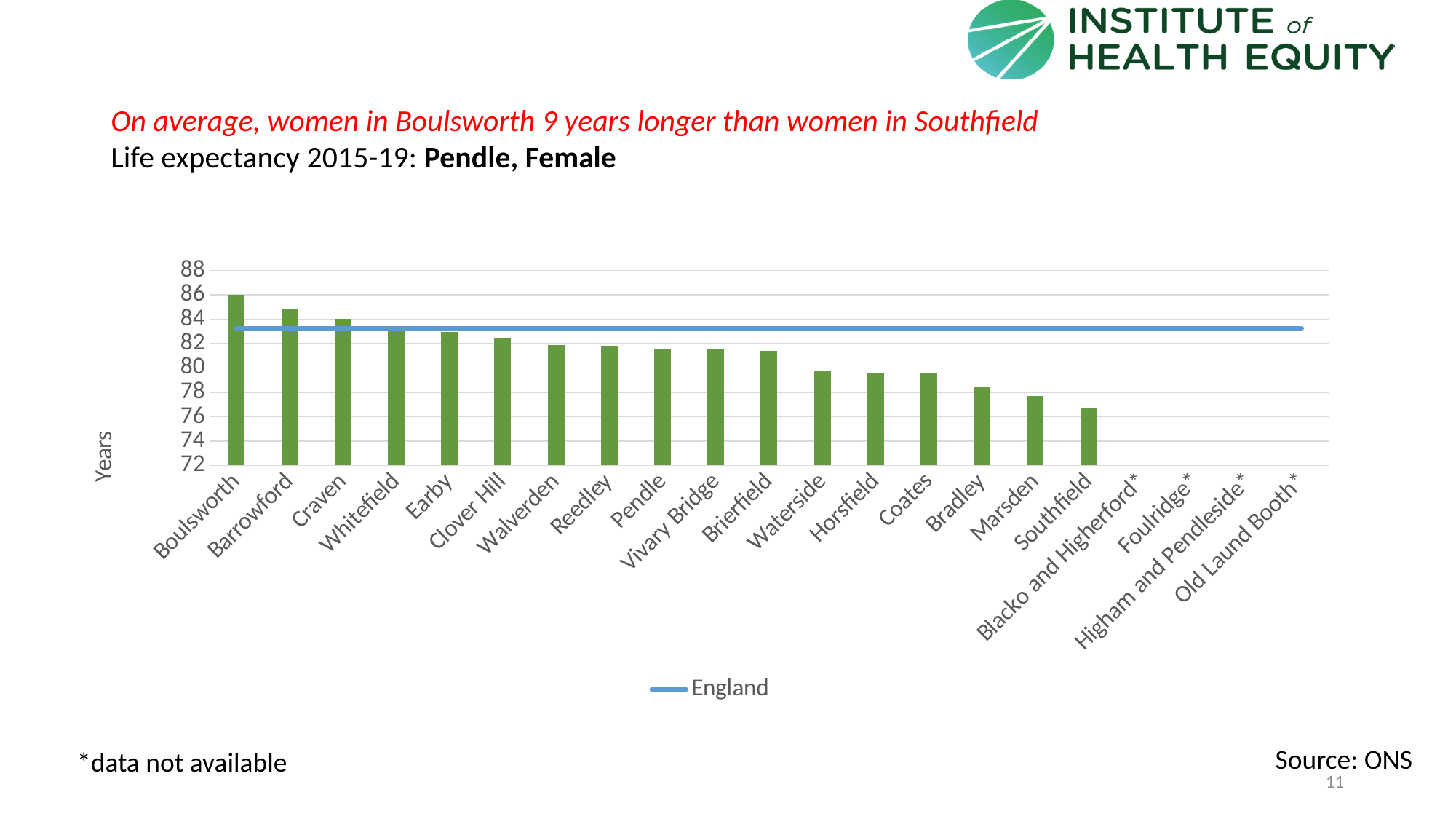
What kind of chart is shown on the slide? bar chart Is the value for Craven greater or less than 82? greater What does the asterisk after a ward name indicate, according to the slide? data not available Which ward has the highest female life expectancy in the chart? Boulsworth How many series does the legend list? 1 Is the value for Southfield greater or less than 78? less Do the bar values rise or fall from left to right along the x axis? fall Which is larger, the value for Barrowford or the value for Craven? Barrowford Is the England line greater or less than 82? greater How many ward labels are shown on the x axis? 21 Among the wards with a bar plotted, which has the lowest female life expectancy? Southfield